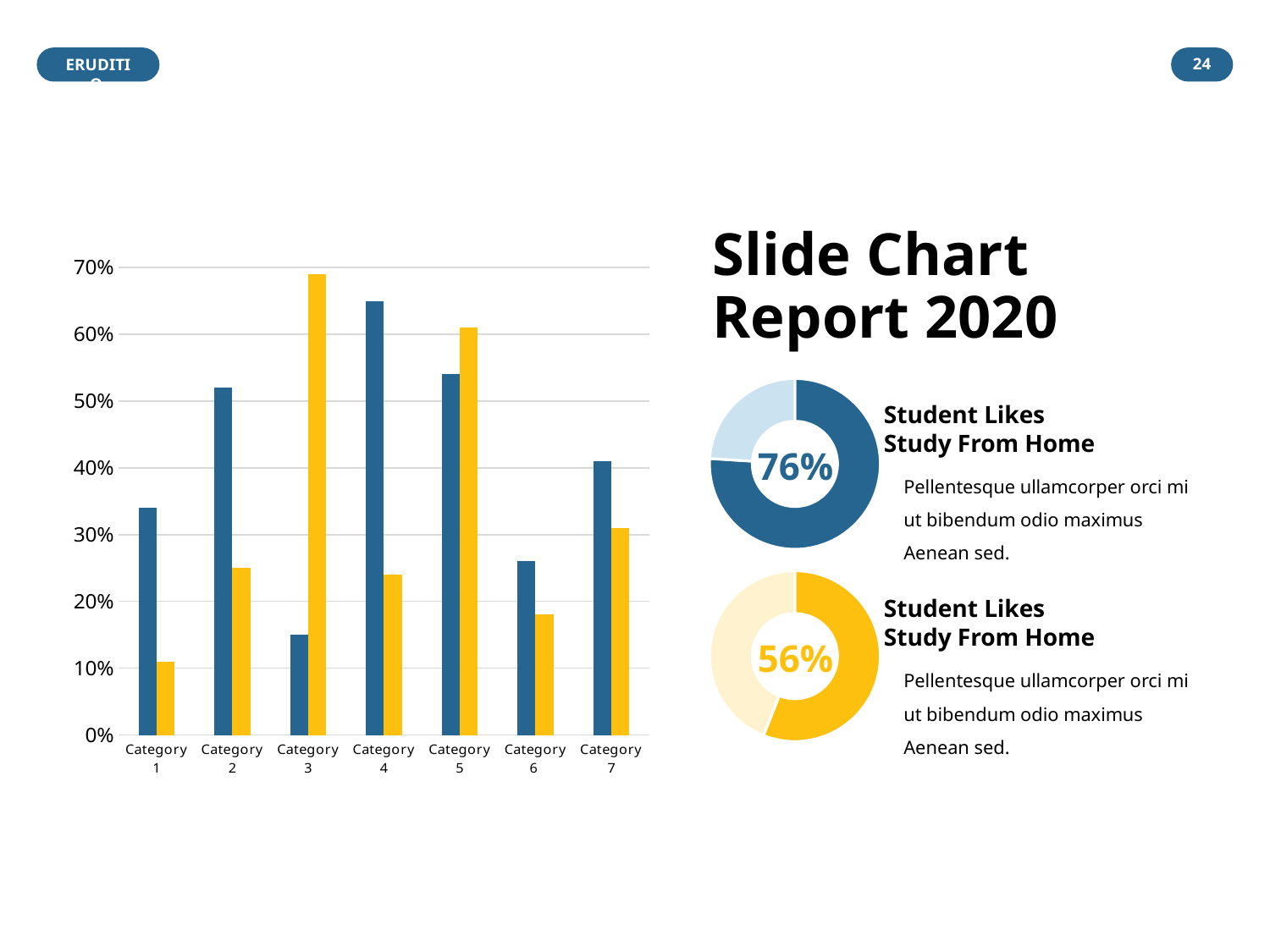
In the bar chart, is the yellow bar for Category 5 greater or less than 50%? greater In the bar chart, is the blue bar for Category 4 greater or less than 60%? greater What percentage is shown in the centre of the yellow donut chart on the right? 56% What kind of chart is the large chart on the left of the slide? bar chart In the bar chart, is the yellow bar for Category 1 greater or less than 20%? less In the bar chart, which category has the tallest yellow bar? Category 3 In the bar chart, for Category 3, which bar is taller, the blue one or the yellow one? the yellow one In the bar chart, which category has the shortest yellow bar? Category 1 What percentage is shown in the centre of the blue donut chart on the right? 76% How many categories are shown on the x axis of the bar chart? 7 In the bar chart, which category has the tallest blue bar? Category 4 In the bar chart, which category has the shortest blue bar? Category 3